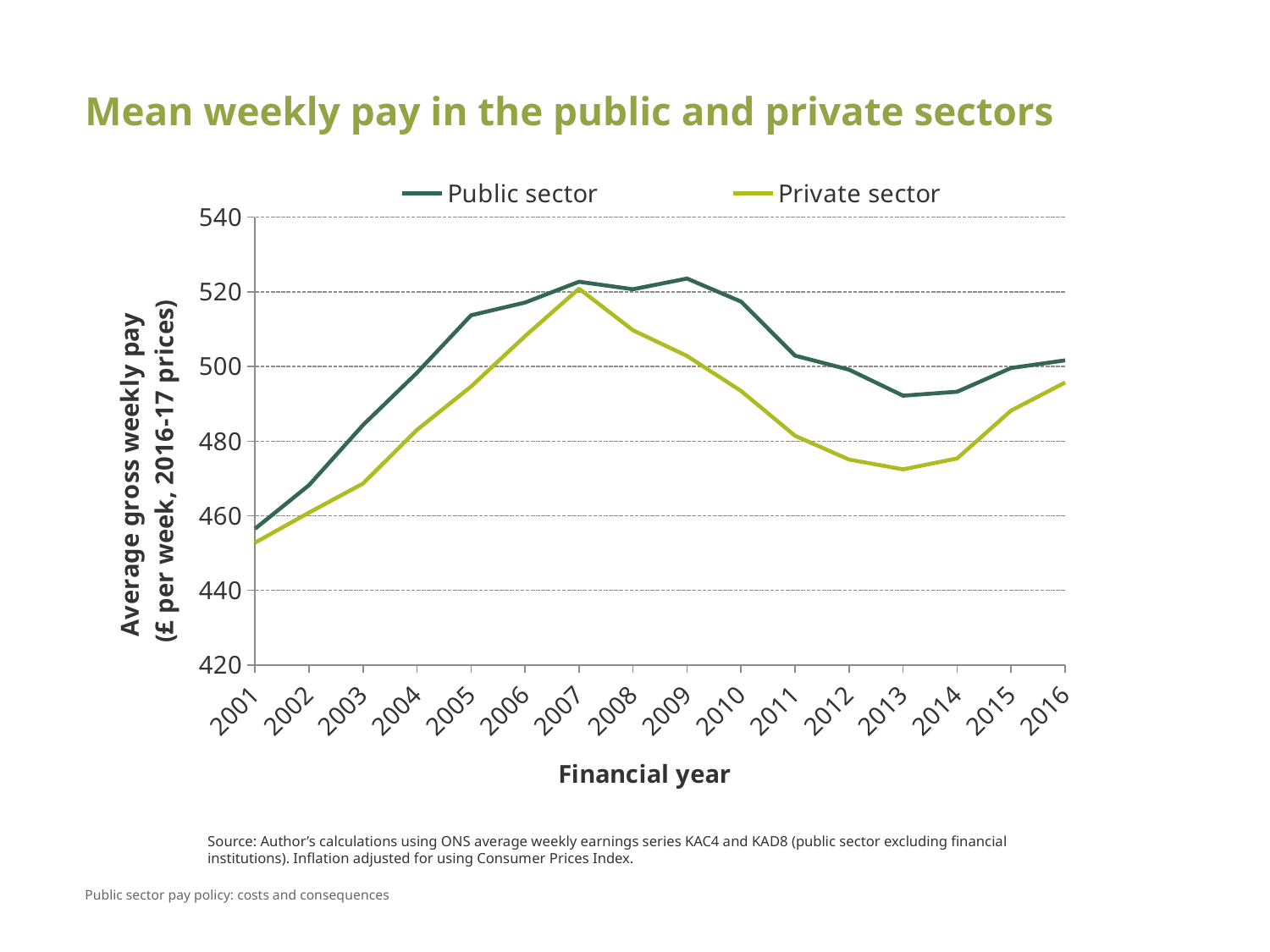
Does the Private sector line rise or fall between 2007 and 2013? Fall In which financial year is the Private sector value highest? 2007 How many financial years are plotted along the x axis? 16 In which financial year is the Public sector value lowest? 2001 How many series does the legend list? 2 What is the label of the y axis? Average gross weekly pay (£ per week, 2016-17 prices) Is the Public sector value for 2005 greater or less than 500? greater Is the Private sector value for 2013 greater or less than 480? less Is the Public sector value for 2001 greater or less than 460? less What kind of chart is shown on the slide? Line chart Which series has the higher value in 2016, Public sector or Private sector? Public sector In which financial year is the Private sector value lowest? 2001